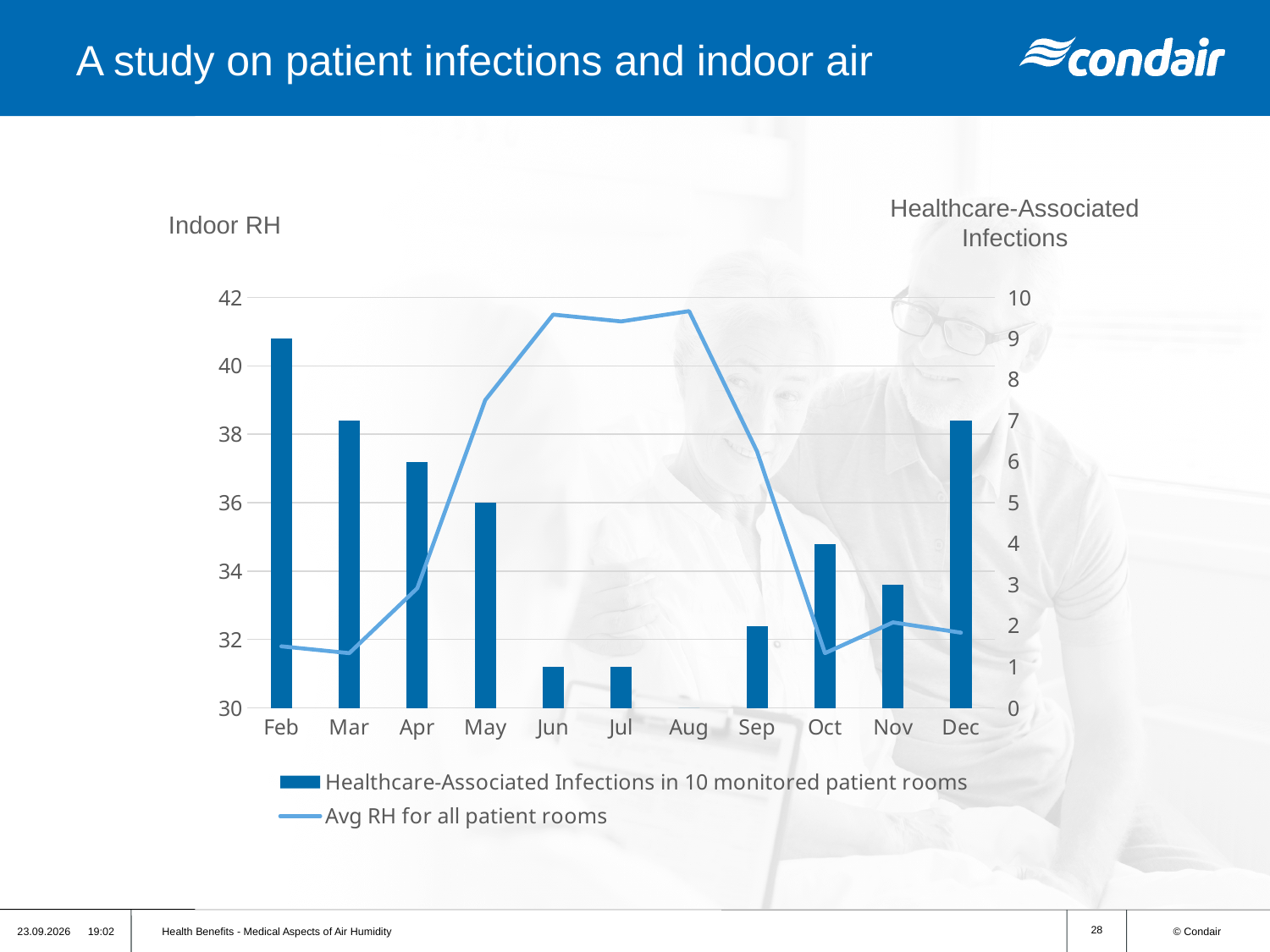
Does the Avg RH for all patient rooms line rise or fall from Mar to Jun? rise Is the Healthcare-Associated Infections bar for Feb greater or less than 8? greater Is the Healthcare-Associated Infections bar for Jun greater or less than 2? less What kind of chart is shown on the slide? A combination bar and line chart Is the Avg RH for all patient rooms in Feb greater or less than 34? less How many months are shown on the x axis? 11 Which month has the highest bar for Healthcare-Associated Infections in 10 monitored patient rooms? Feb How many series does the legend list? 2 What is the title of the left-hand vertical axis? Indoor RH Which is larger, the Healthcare-Associated Infections bar for Feb or for Dec? Feb